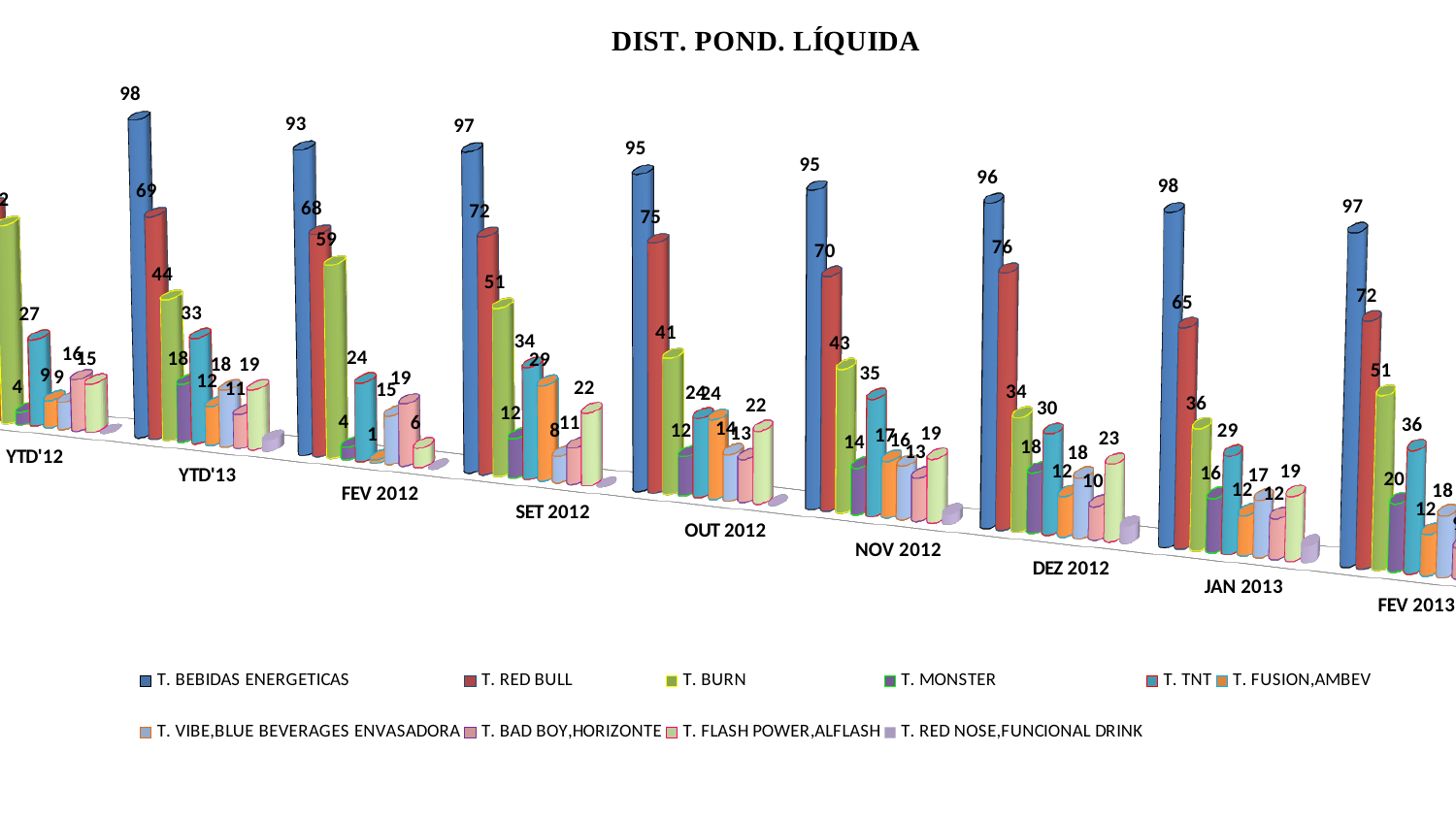
What is the value for T. RED BULL in FEV 2013? 72 Which is larger in OUT 2012: T. RED BULL or T. BURN? T. RED BULL How many series does the legend list? 10 What is the difference between T. BEBIDAS ENERGETICAS and T. RED BULL in SET 2012? 25 What is the value for T. RED BULL in DEZ 2012? 76 What is the value for T. BEBIDAS ENERGETICAS in FEV 2012? 93 What is the value for T. BURN in FEV 2012? 59 What is the difference between T. RED BULL in DEZ 2012 and T. RED BULL in JAN 2013? 11 What type of chart is shown on the slide? bar chart Which series has the highest value in NOV 2012? T. BEBIDAS ENERGETICAS What is the value for T. BEBIDAS ENERGETICAS in JAN 2013? 98 What is the title of the chart? DIST. POND. LÍQUIDA